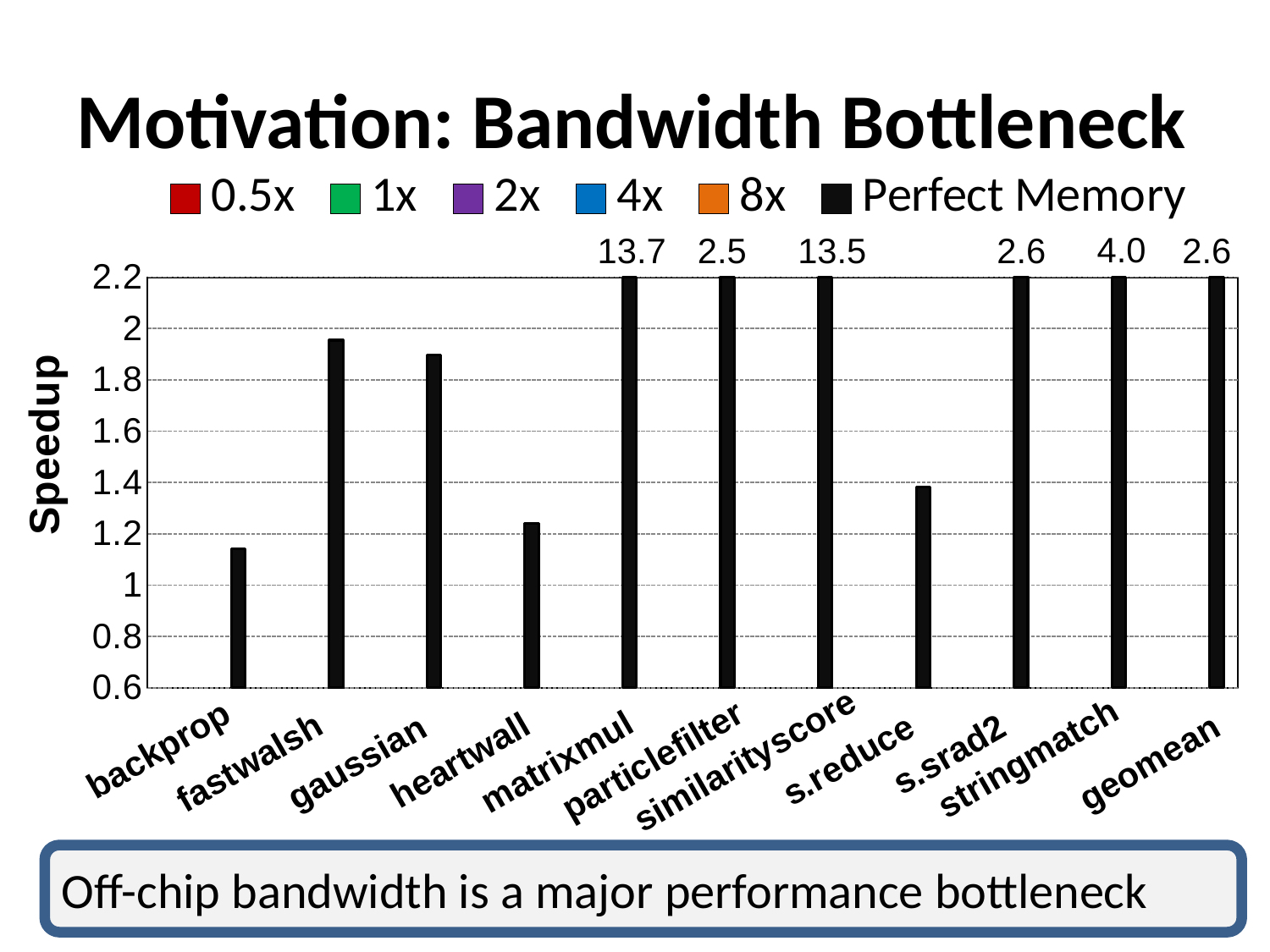
What kind of chart is shown on the slide? bar chart Is the speedup for fastwalsh greater or less than 1.8? greater What is the Perfect Memory speedup for matrixmul? 13.7 Which has a larger speedup, particlefilter or s.srad2? s.srad2 How many series does the legend list? 6 Which benchmark has the highest speedup? matrixmul What is the geomean speedup shown on the chart? 2.6 Is the speedup for backprop greater or less than 1.2? less How many benchmarks (categories) are shown on the x axis? 11 What is the label of the y axis? Speedup What is the Perfect Memory speedup for stringmatch? 4.0 What is the difference between the speedups of matrixmul and similarityscore? 0.2